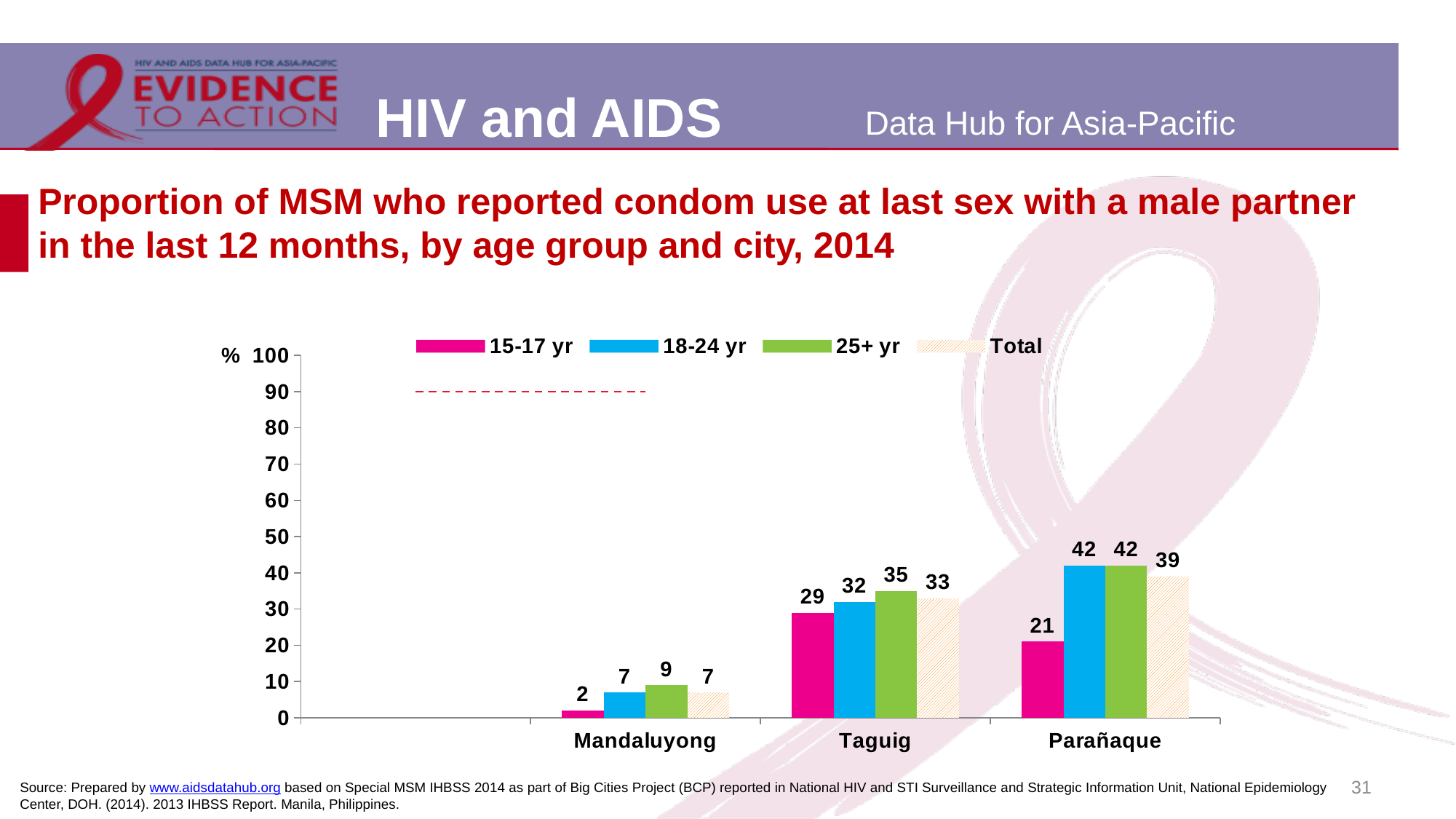
What is the difference between the 25+ yr value and the 15-17 yr value in Taguig? 6 What is the value for the 25+ yr group in Mandaluyong? 9 Which legend entry is shown in green? 25+ yr Which city has the lowest Total value? Mandaluyong How many series does the legend list? 4 Is the Total value for Taguig greater or less than 30? greater What kind of chart is shown on the slide? Bar chart What is the Total value for Parañaque? 39 What is the value for the 15-17 yr group in Taguig? 29 Which city has the highest value for the 18-24 yr group? Parañaque Which is larger: the 15-17 yr value in Parañaque or the 18-24 yr value in Taguig? 18-24 yr value in Taguig How many cities are shown on the x axis? 3